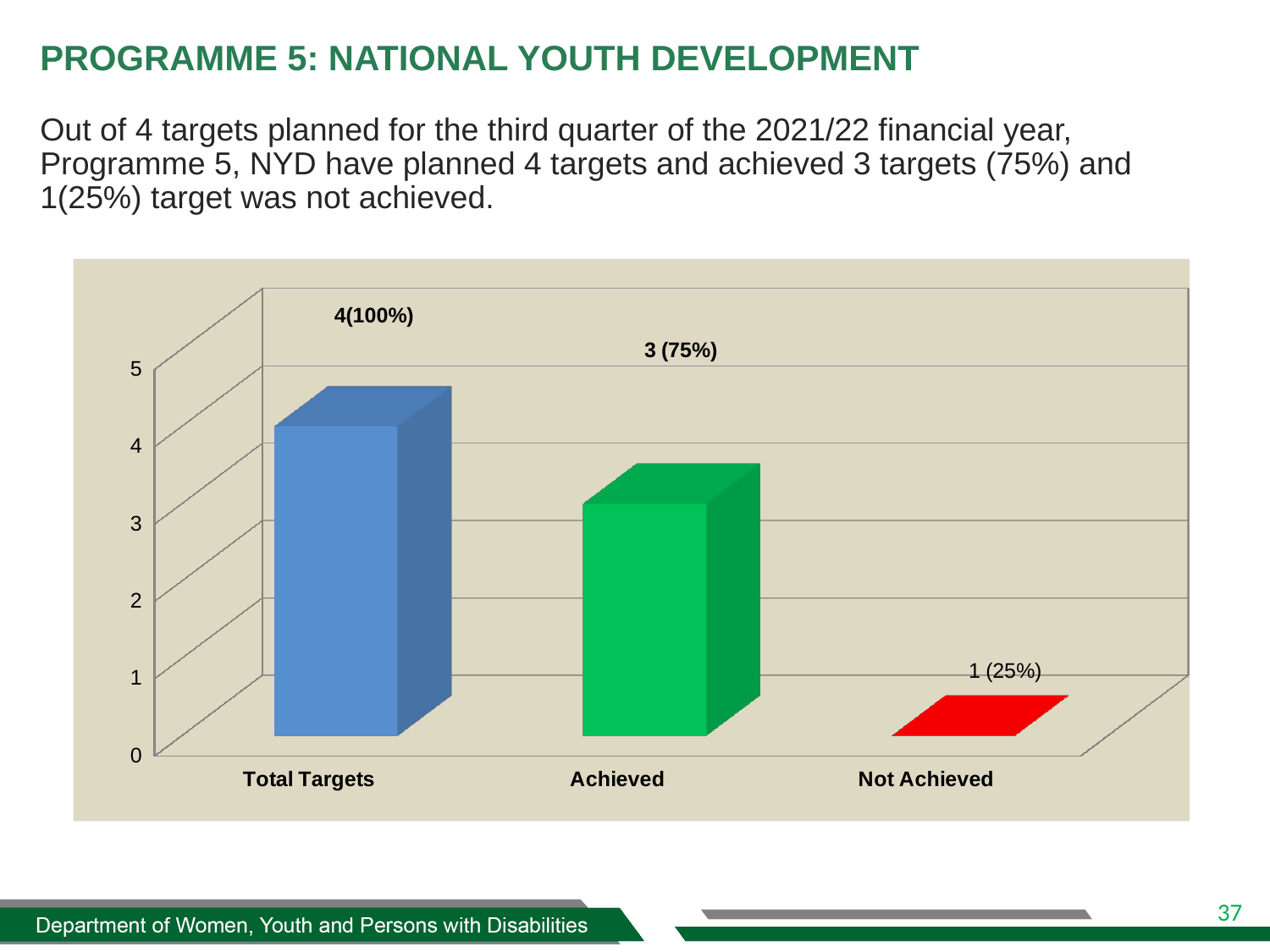
How many categories are shown on the x axis? 3 Which category has the lowest value? Not Achieved What is the data label shown for Total Targets? 4(100%) What kind of chart is shown on the slide? bar chart What is the difference between the number Achieved and the number Not Achieved? 2 What is the difference between the number of Total Targets and the number Achieved? 1 Which category has the highest value? Total Targets What colour is the bar for Not Achieved? red Is the value for Achieved greater or less than 2? greater Which is larger, the value for Achieved or the value for Not Achieved? Achieved What is the data label shown for Not Achieved? 1 (25%) What is the data label shown for Achieved? 3 (75%)